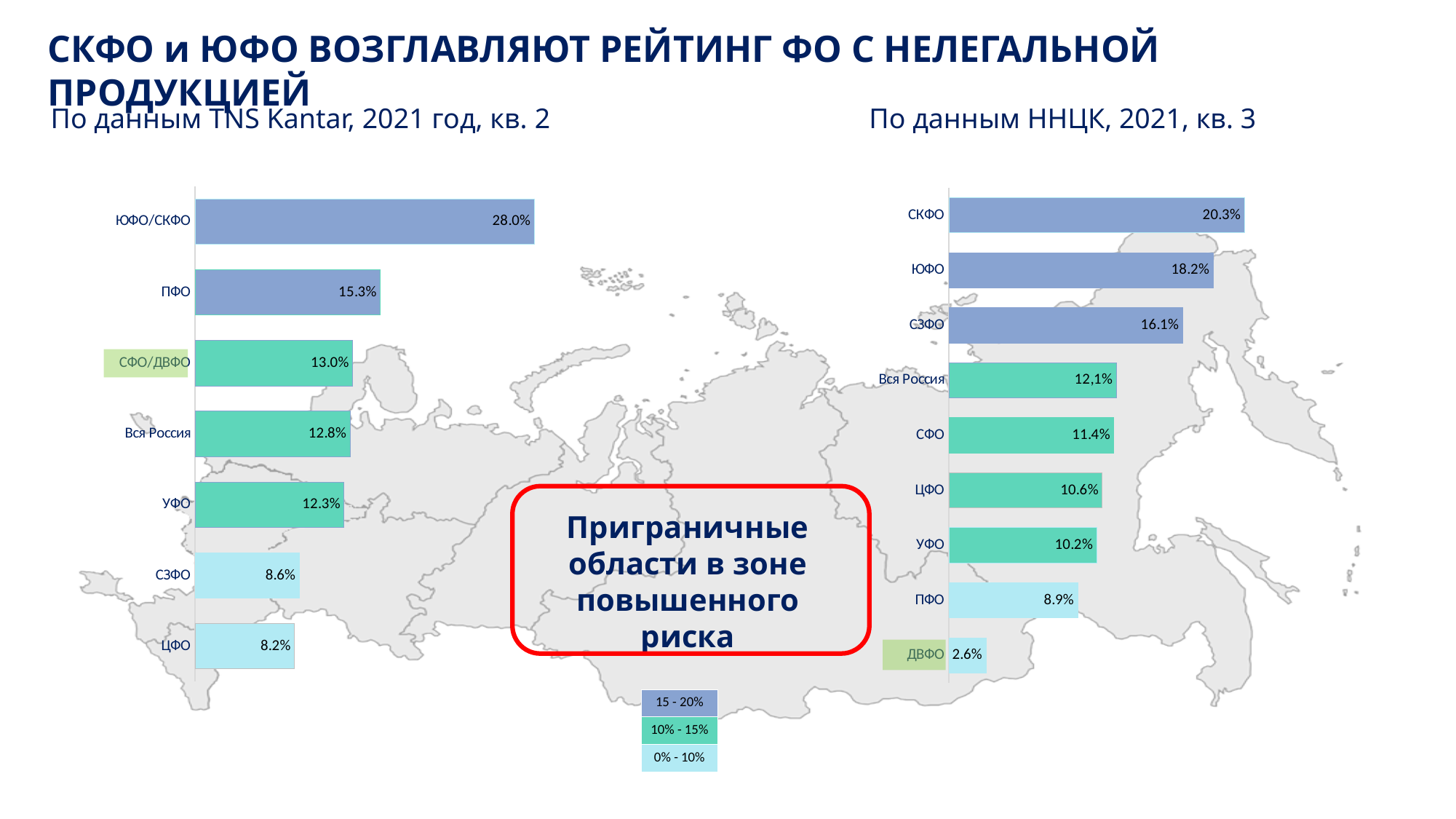
In the left chart (По данным TNS Kantar, 2021 год, кв. 2), what is the value for Вся Россия? 12.8% In the left chart (По данным TNS Kantar, 2021 год, кв. 2), how many categories are plotted? 7 In the right chart (По данным ННЦК, 2021, кв. 3), what is the value for СЗФО? 16.1% In the right chart (По данным ННЦК, 2021, кв. 3), what is the difference between СКФО and ЮФО? 2.1% In the right chart (По данным ННЦК, 2021, кв. 3), which category has the highest value? СКФО In the left chart (По данным TNS Kantar, 2021 год, кв. 2), what is the difference between ПФО and СЗФО? 6.7% In the right chart (По данным ННЦК, 2021, кв. 3), what is the value for ДВФО? 2.6% In the left chart (По данным TNS Kantar, 2021 год, кв. 2), which category has the lowest value? ЦФО What kind of chart is used on the left side of the slide (По данным TNS Kantar, 2021 год, кв. 2)? Bar chart In the right chart (По данным ННЦК, 2021, кв. 3), how many categories are plotted? 9 In the left chart (По данным TNS Kantar, 2021 год, кв. 2), what is the value for ЮФО/СКФО? 28.0% In the right chart (По данным ННЦК, 2021, кв. 3), which is larger: ЦФО or ПФО? ЦФО